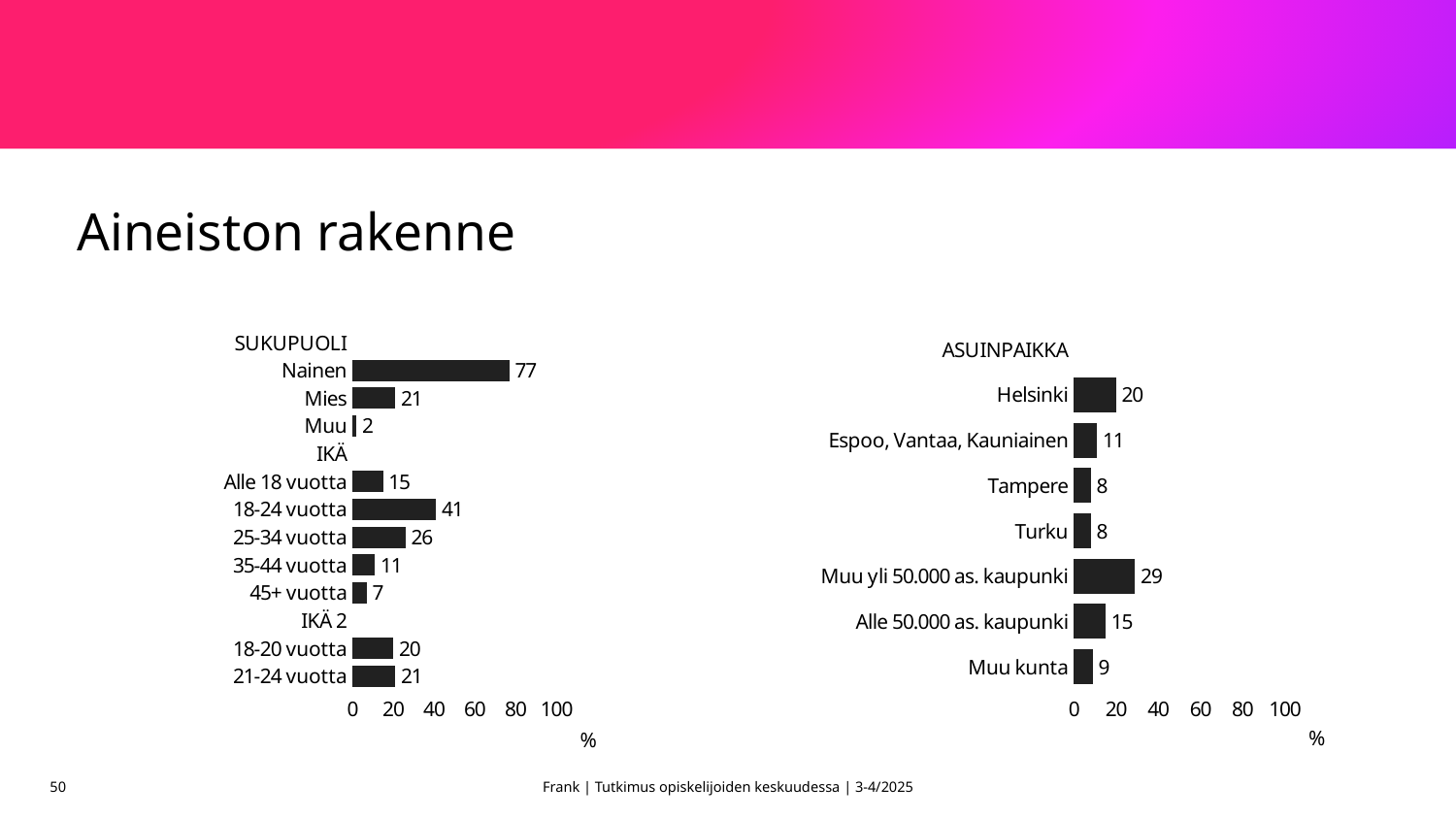
In the right chart (ASUINPAIKKA), what is the value for Muu kunta? 9 In the right chart (ASUINPAIKKA), what is the value for Helsinki? 20 In the left chart (SUKUPUOLI / IKÄ), which age group under IKÄ has the lowest value? 45+ vuotta In the left chart (SUKUPUOLI / IKÄ), what is the value for 18-24 vuotta? 41 In the left chart (SUKUPUOLI / IKÄ), what is the value for Nainen? 77 In the left chart (SUKUPUOLI / IKÄ), what is the value for 21-24 vuotta? 21 In the left chart (SUKUPUOLI / IKÄ), which is larger, 25-34 vuotta or 35-44 vuotta? 25-34 vuotta In the right chart (ASUINPAIKKA), what is the difference between the values for Muu yli 50.000 as. kaupunki and Alle 50.000 as. kaupunki? 14 In the right chart (ASUINPAIKKA), which category has the highest value? Muu yli 50.000 as. kaupunki What kind of chart is the right chart (ASUINPAIKKA)? Bar chart In the left chart (SUKUPUOLI / IKÄ), what is the difference between the values for Nainen and Mies? 56 In the right chart (ASUINPAIKKA), how many categories are plotted? 7